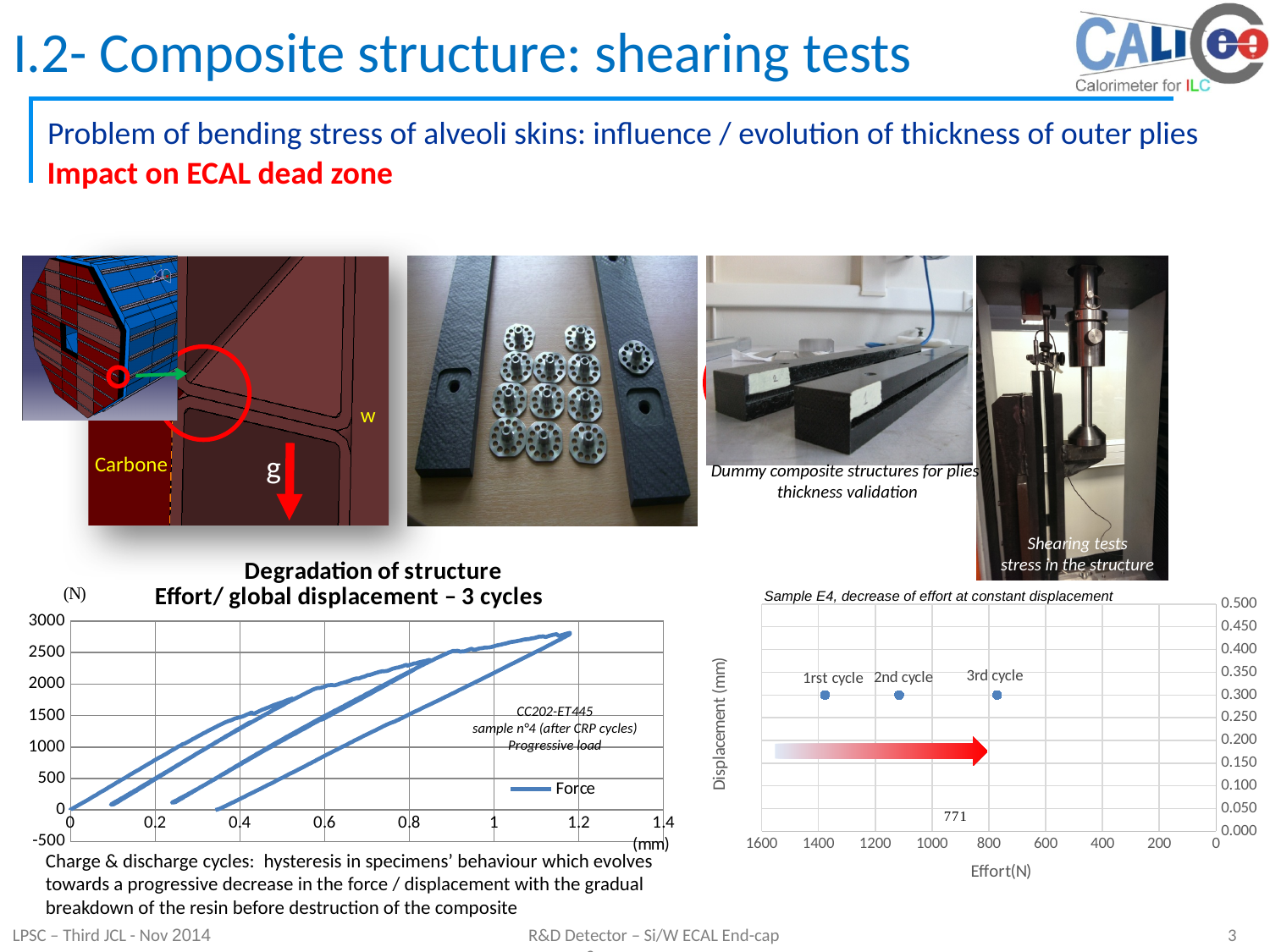
On the 'Effort/ global displacement – 3 cycles' chart, is the maximum force reached greater or less than 2500? greater How many series does the legend of the 'Effort/ global displacement – 3 cycles' chart list? 1 How many data points are plotted on the 'Sample E4, decrease of effort at constant displacement' chart? 3 On the 'Sample E4, decrease of effort at constant displacement' chart, is the effort for the 3rd cycle greater or less than 1000? less On the 'Sample E4, decrease of effort at constant displacement' chart, does the effort increase or decrease from the 1rst cycle to the 3rd cycle? decrease What numeric data label is printed on the 'Sample E4, decrease of effort at constant displacement' chart? 771 What is the highest value shown on the y axis of the 'Effort/ global displacement – 3 cycles' chart? 3000 What is the name of the series in the legend of the 'Effort/ global displacement – 3 cycles' chart? Force What kind of chart is the 'Effort/ global displacement – 3 cycles' chart on the left? line chart On the 'Sample E4, decrease of effort at constant displacement' chart, which has the higher effort, the 1rst cycle or the 3rd cycle? 1rst cycle On the 'Sample E4, decrease of effort at constant displacement' chart, is the effort for the 1rst cycle greater or less than 1200? greater